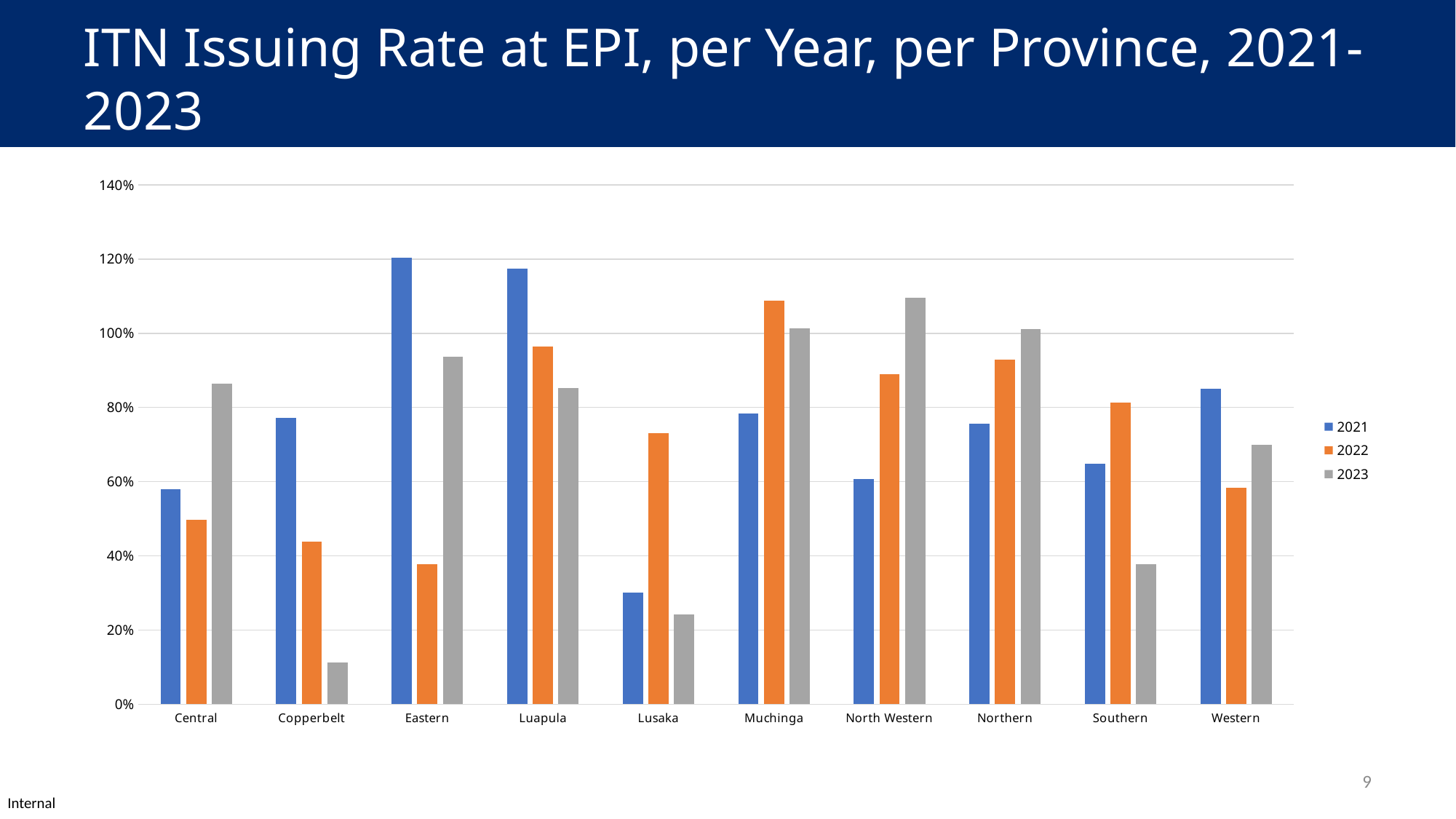
Is the 2021 value for Eastern greater or less than 100%? greater Which province has the lowest 2023 value? Copperbelt Which province has the highest 2023 value? North Western Which colour represents the 2022 series in the legend? orange Is the 2023 value for Copperbelt greater or less than 20%? less What type of chart is shown on the slide? bar chart Which province has the highest 2022 value? Muchinga For Southern, which year has the larger value, 2022 or 2023? 2022 How many provinces are shown on the x axis? 10 Is the 2022 value for Lusaka greater or less than 60%? greater How many series does the legend list? 3 Which province has the lowest 2021 value? Lusaka